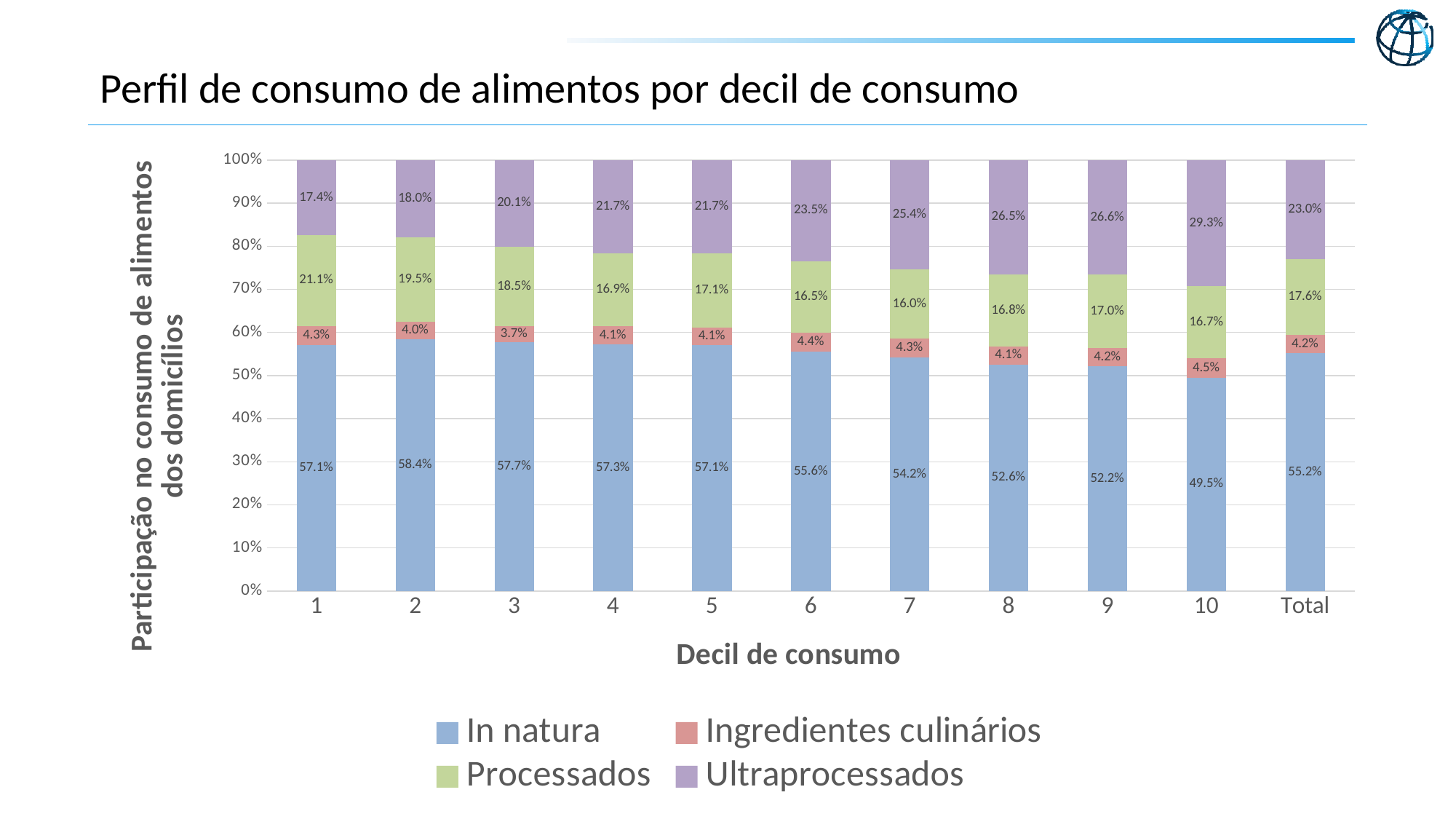
How many categories are shown on the x axis? 11 Which decil has the highest Ultraprocessados share? 10 What type of chart is shown on the slide? Stacked bar chart Which is larger, the Processados share for decil 2 or for decil 9? Decil 2 Does the In natura share rise or fall from decil 1 to decil 10? Fall What is the Ingredientes culinários share for decil 3? 3.7% What is the In natura share for decil 10? 49.5% What is the Processados share for decil 1? 21.1% What is the Ultraprocessados share for the Total category? 23.0% How many series does the legend list? 4 Which decil has the lowest In natura share? 10 What is the difference between the Ultraprocessados share for decil 10 and decil 1? 11.9%